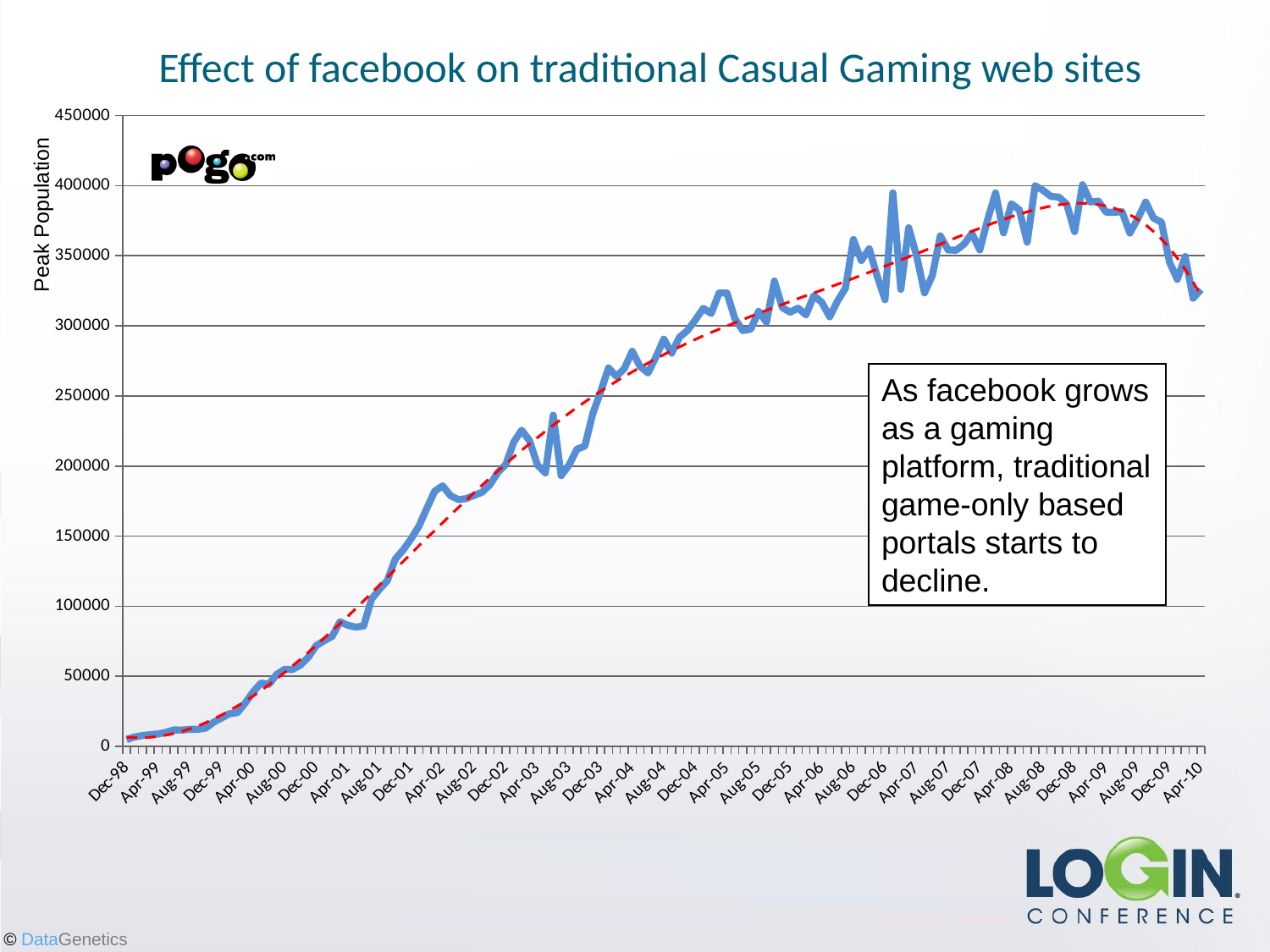
Does the peak population rise or fall between Dec-98 and Dec-06? rise Which date on the x axis has the lowest peak population? Dec-98 Is the value for Apr-02 greater or less than 150000? greater Is the value for Apr-10 greater or less than 300000? greater Is the value for Apr-04 greater or less than 300000? less Does the peak population rise or fall between Dec-08 and Apr-10? fall What is the title of the chart? Effect of facebook on traditional Casual Gaming web sites What kind of chart is shown on the slide? line chart What is the label of the vertical axis? Peak Population